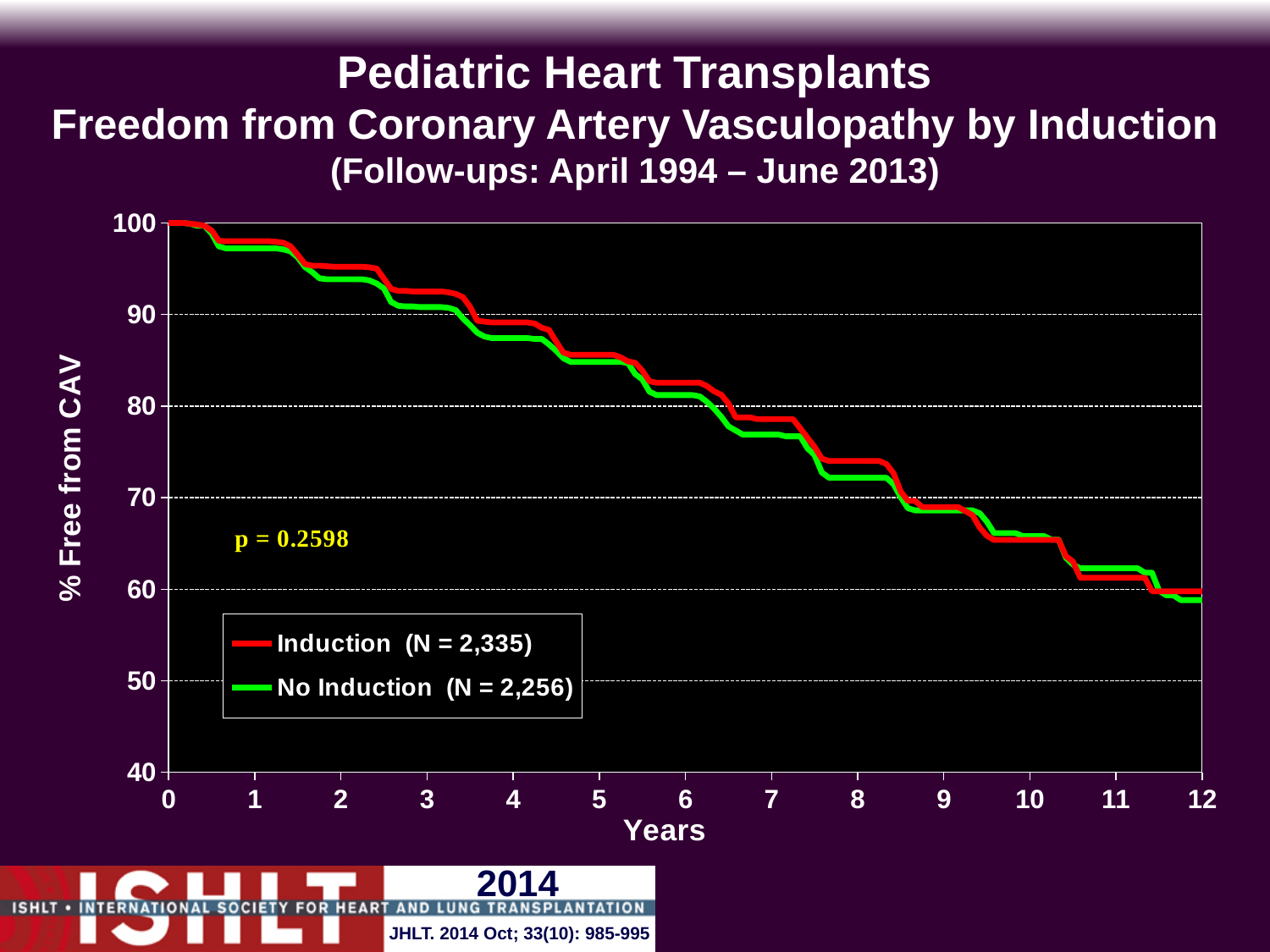
At year 8, which group has the higher % Free from CAV, Induction or No Induction? Induction What p-value is printed on the chart? p = 0.2598 How many year tick marks are labelled on the x axis? 13 What is the % Free from CAV for both groups at year 0? 100 Is the value for the Induction group at year 10 greater or less than 70? less What kind of chart is shown on the slide? line chart Do the values for % Free from CAV rise or fall as Years increase? fall Is the value for the No Induction group at year 7 greater or less than 80? less What is the sample size (N) shown in the legend for the Induction group? 2,335 Is the value for the No Induction group at year 5 greater or less than 80? greater How many series does the legend list? 2